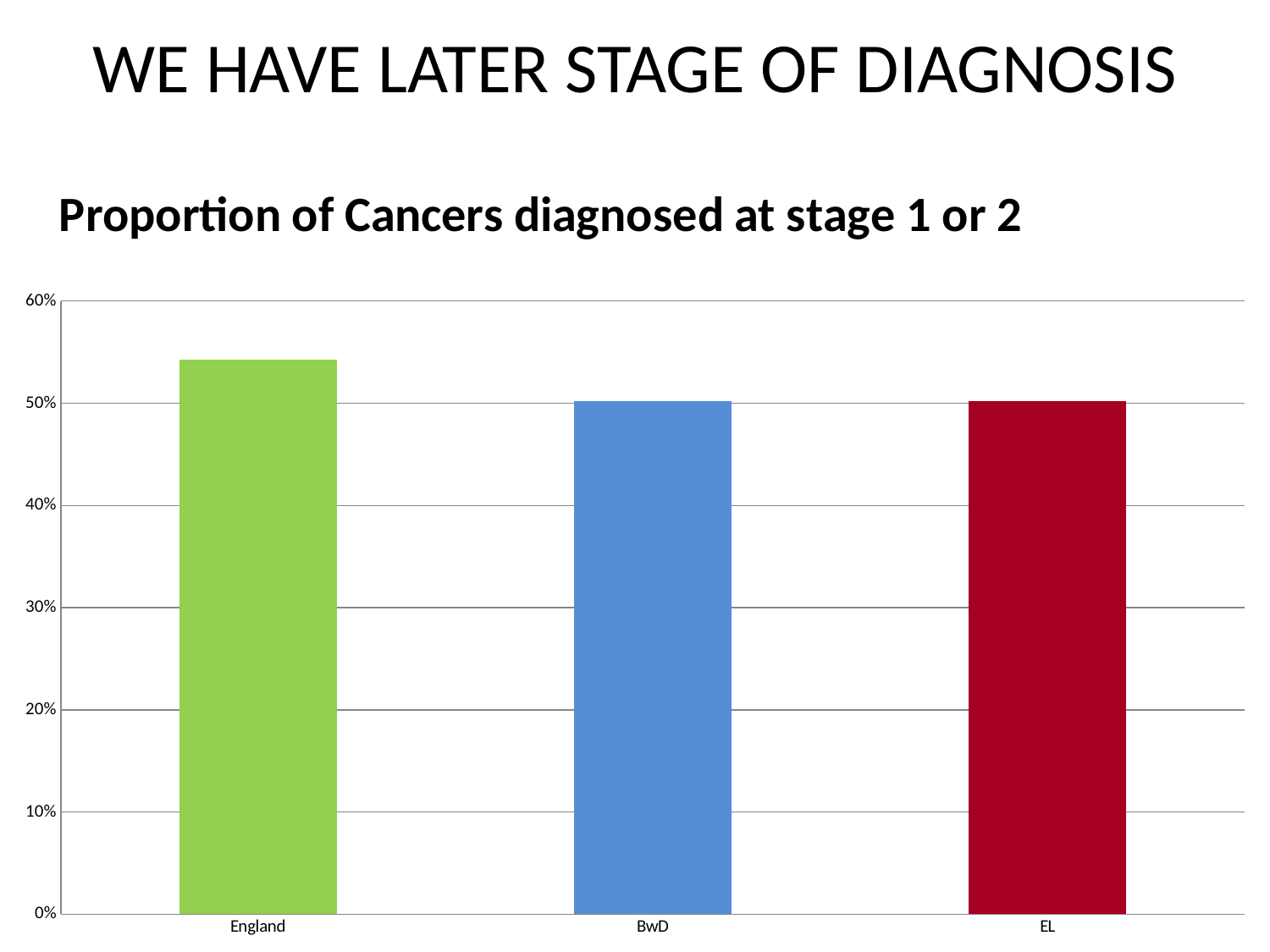
Which is larger, the value for England or the value for BwD? England How many categories are plotted on the chart? 3 Is the value for EL greater or less than 40%? greater Which is larger, the value for EL or the value for England? England Is the value for England greater or less than 50%? greater What colour is the bar for BwD? blue What is the title of the chart? Proportion of Cancers diagnosed at stage 1 or 2 Is the value for EL greater or less than 60%? less Which category has the highest proportion of cancers diagnosed at stage 1 or 2? England What kind of chart is shown on the slide? bar chart